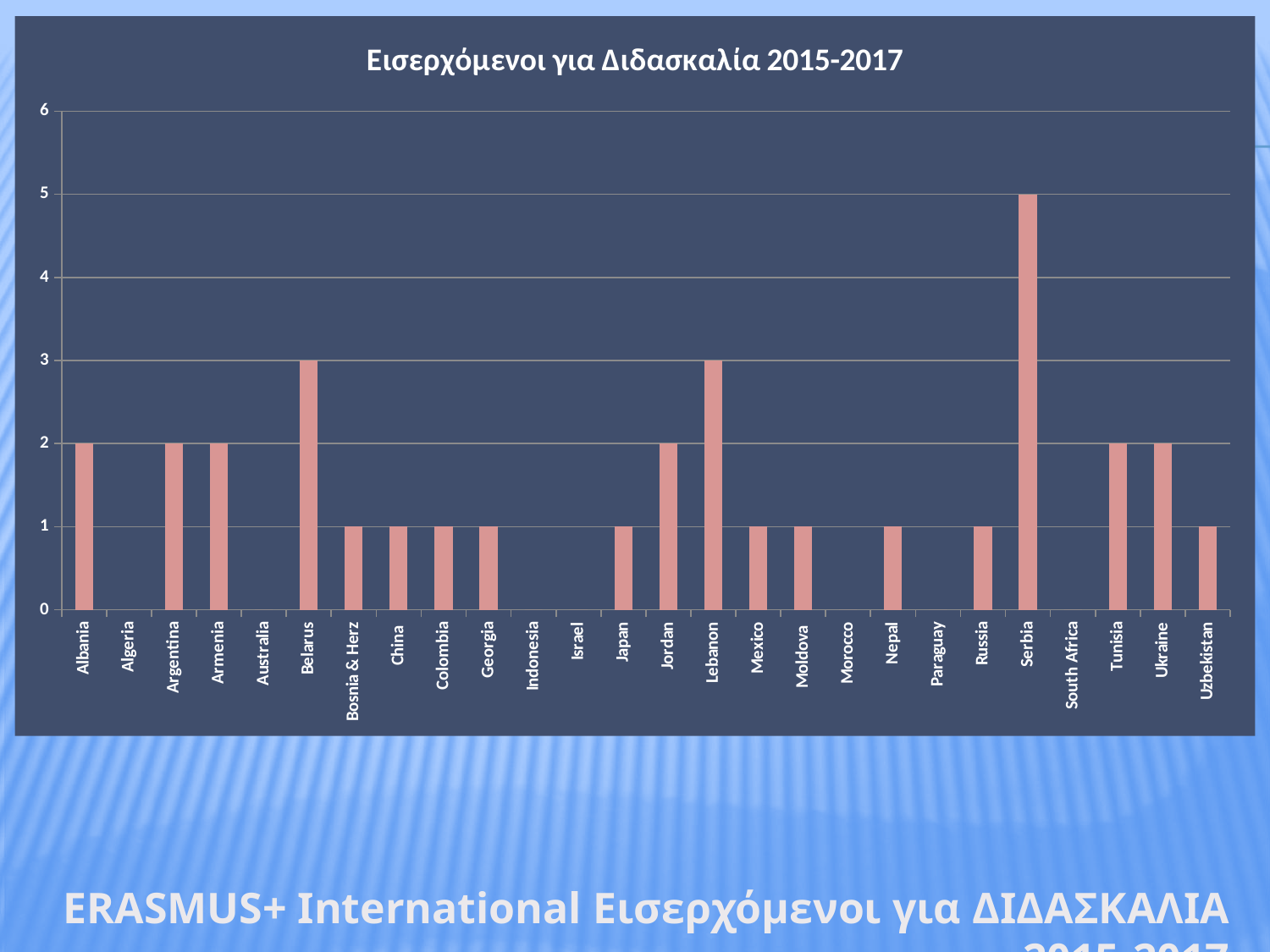
What is the value for Lebanon? 3 What is the value for Albania? 2 What is the value for Serbia? 5 What is the difference between the values for Serbia and Belarus? 2 What type of chart is shown on the slide? bar chart Which has a larger value, Jordan or Lebanon? Lebanon How many countries are listed on the x axis of the chart? 26 What is the title of the chart? Εισερχόμενοι για Διδασκαλία 2015-2017 What is the value for Belarus? 3 What is the value for China? 1 Which country has the highest value in the chart? Serbia Is the value for Serbia greater or less than 4? greater